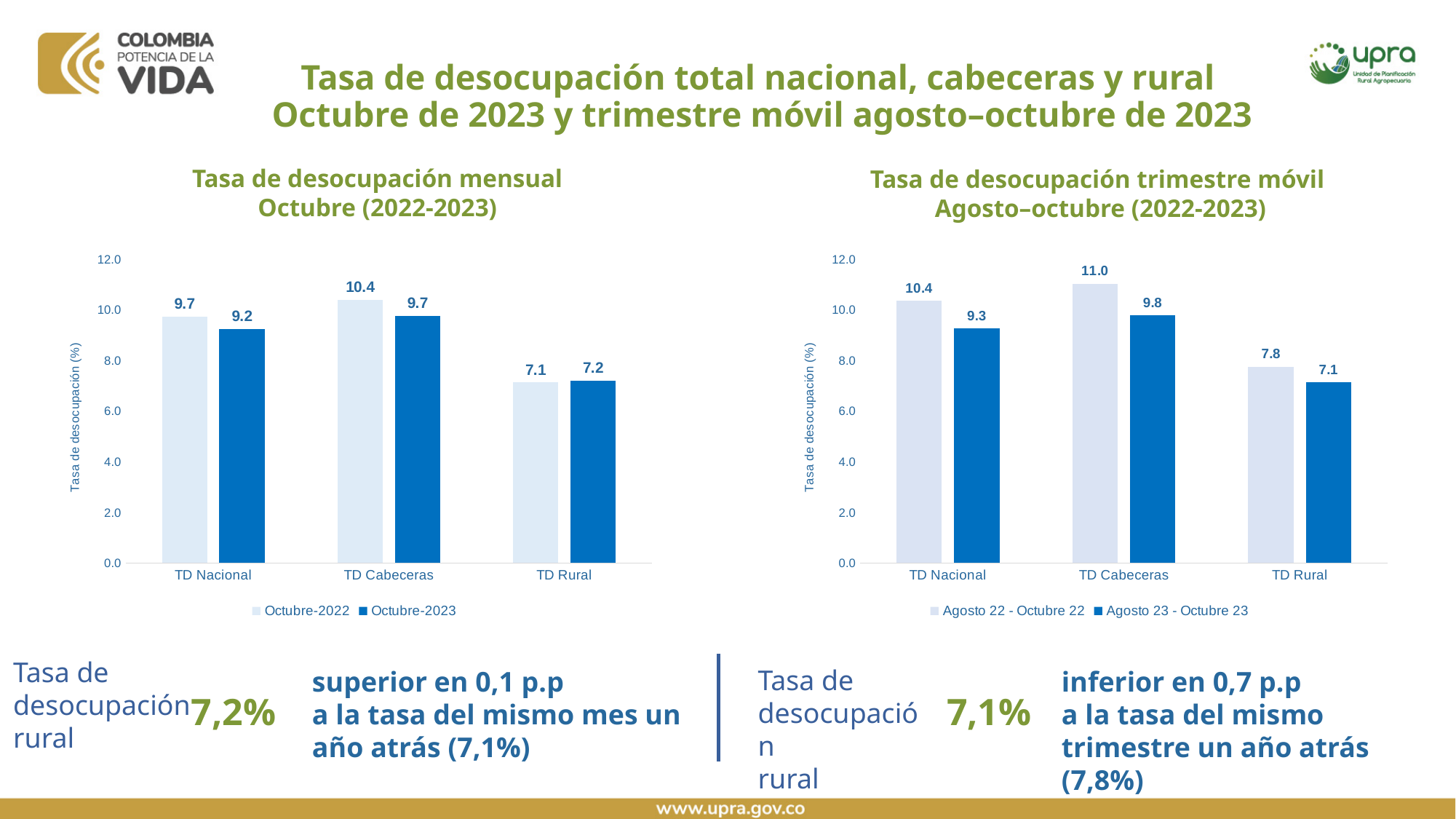
In the right chart (Tasa de desocupación trimestre móvil), what is the value for TD Nacional in Agosto 23 - Octubre 23? 9.3 What is the y-axis label of the right chart (Tasa de desocupación trimestre móvil)? Tasa de desocupación (%) In the left chart (Tasa de desocupación mensual Octubre), what is the value for TD Cabeceras in Octubre-2023? 9.7 In the right chart (Tasa de desocupación trimestre móvil), which category has the highest value for Agosto 22 - Octubre 22? TD Cabeceras What type of chart is the left chart (Tasa de desocupación mensual Octubre)? Bar chart In the left chart (Tasa de desocupación mensual Octubre), what is the value for TD Rural in Octubre-2022? 7.1 In the right chart (Tasa de desocupación trimestre móvil), what is the difference between the TD Cabeceras values for Agosto 22 - Octubre 22 and Agosto 23 - Octubre 23? 1.2 In the left chart (Tasa de desocupación mensual Octubre), how many categories are shown on the x axis? 3 In the left chart (Tasa de desocupación mensual Octubre), which category has the lowest value for Octubre-2023? TD Rural In the right chart (Tasa de desocupación trimestre móvil), how many series does the legend list? 2 In the left chart (Tasa de desocupación mensual Octubre), what is the difference between the TD Nacional values for Octubre-2022 and Octubre-2023? 0.5 In the right chart (Tasa de desocupación trimestre móvil), which is larger for TD Rural: Agosto 22 - Octubre 22 or Agosto 23 - Octubre 23? Agosto 22 - Octubre 22